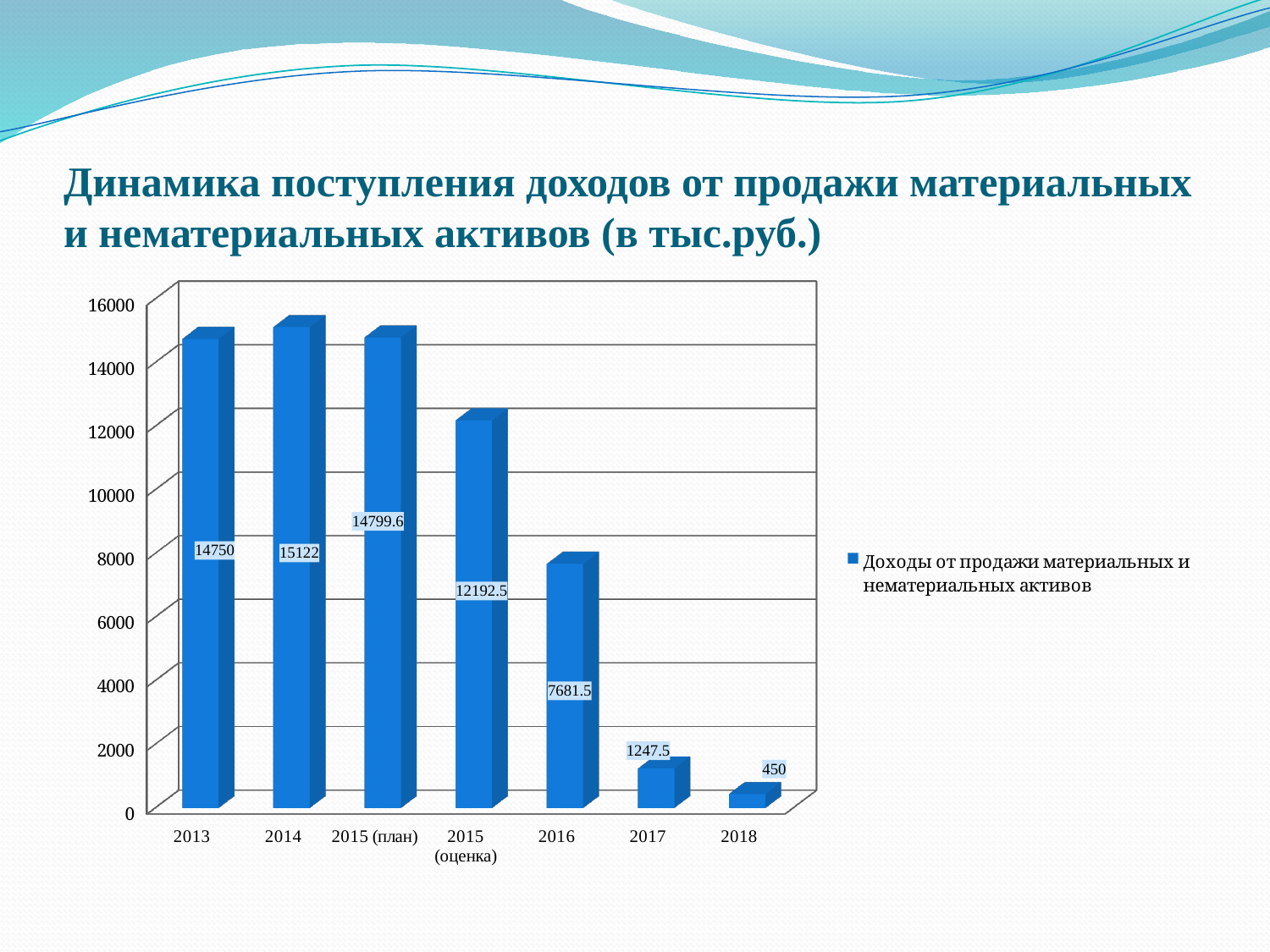
Which category has the highest value? 2014 Which is larger, the value for 2013 or the value for 2015 (план)? 2015 (план) What is the difference between the values for 2016 and 2017? 6434 How many categories are shown on the x axis? 7 Do the values rise or fall from 2015 (план) to 2018? fall What kind of chart is shown? bar chart What is the value for 2013? 14750 What is the value for 2015 (оценка)? 12192.5 What is the value for 2017? 1247.5 How many series does the legend list? 1 Which category has the lowest value? 2018 Is the value for 2016 greater or less than 8000? less